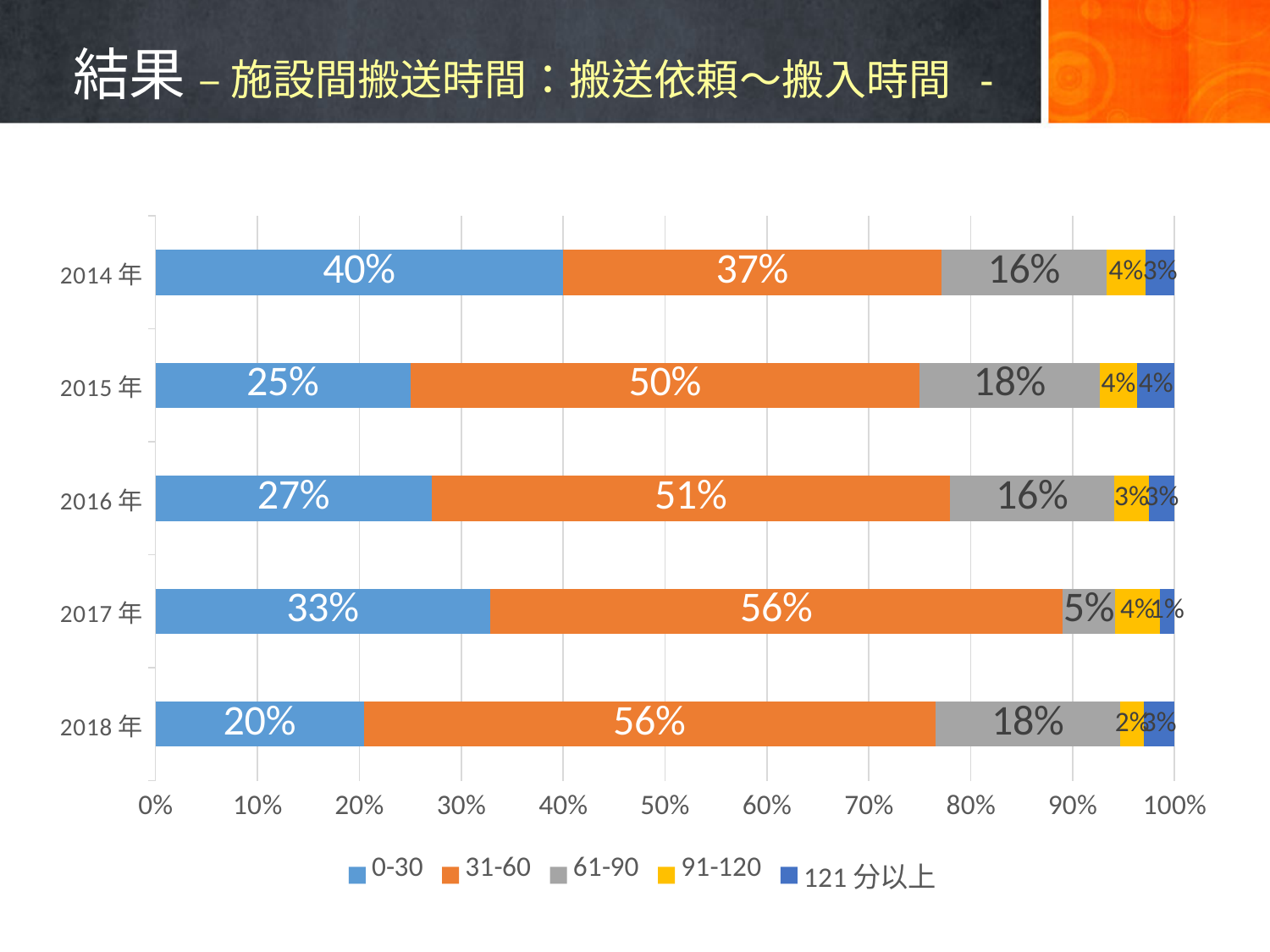
What is the difference between the 31-60 values for 2015年 and 2014年? 13 percentage points What is the value of the 91-120 series for 2015年? 4% Which year has the lowest value for the 0-30 series? 2018年 Which year has the highest value for the 0-30 series? 2014年 What is the value of the 61-90 series for 2018年? 18% What is the value of the 31-60 series for 2017年? 56% How many years are shown on the chart? 5 Which series is shown in light blue according to the legend? 0-30 What kind of chart is shown on the slide? Stacked bar chart Which year has the larger 61-90 value, 2015年 or 2017年? 2015年 What is the value of the 0-30 series for 2014年? 40% How many series does the legend list? 5